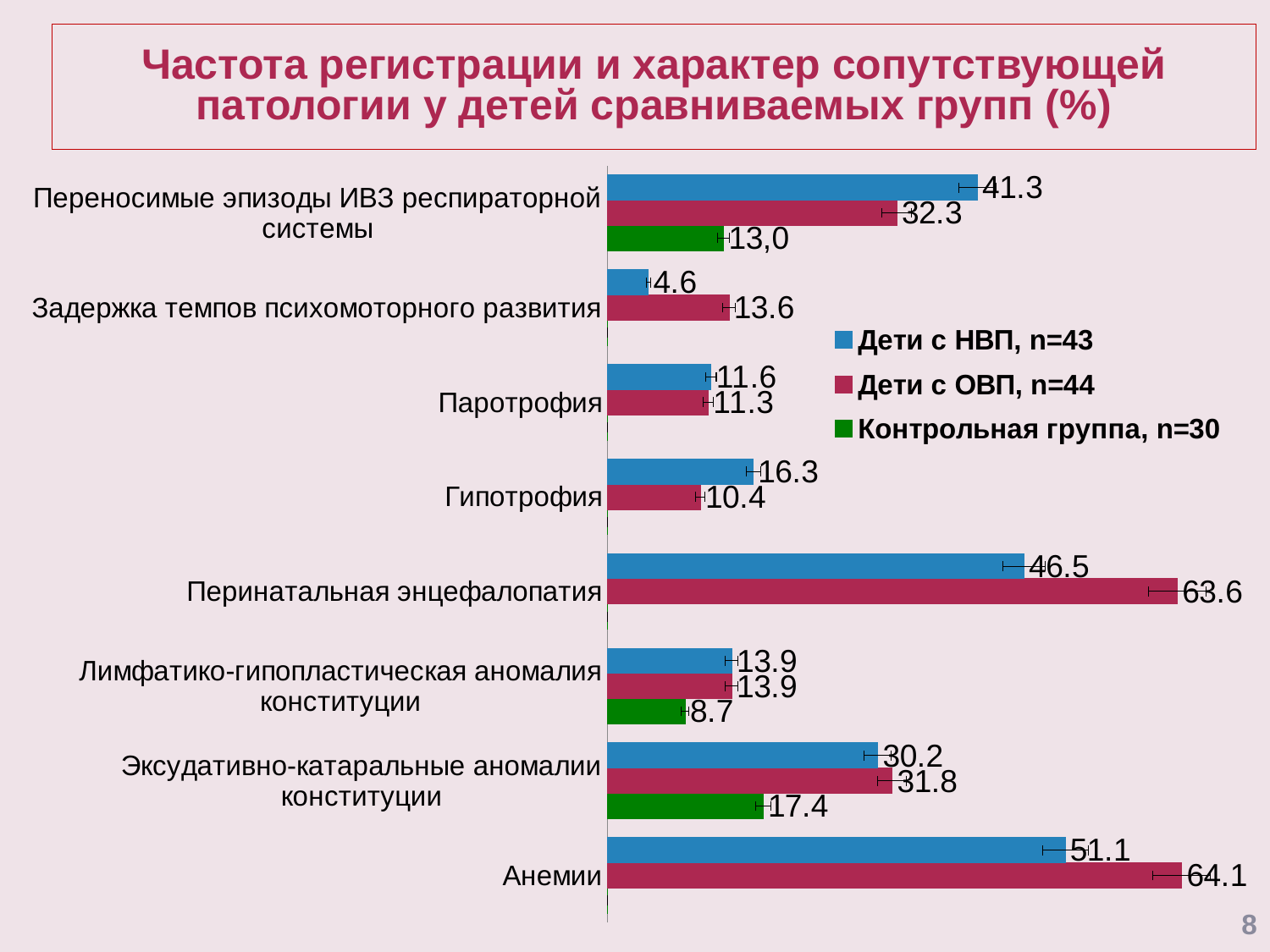
Which colour represents Контрольная группа, n=30 in the legend? Green For Гипотрофия, which series has the larger value: Дети с НВП, n=43 or Дети с ОВП, n=44? Дети с НВП, n=43 How many categories are shown on the chart? 8 What is the value for Контрольная группа, n=30 for Эксудативно-катаральные аномалии конституции? 17.4 Which category has the highest value for Дети с ОВП, n=44? Анемии What is the value for Дети с НВП, n=43 for Анемии? 51.1 What kind of chart is shown on the slide? Bar chart How many series does the legend list? 3 What is the value for Дети с ОВП, n=44 for Перинатальная энцефалопатия? 63.6 Which category has the lowest value for Дети с НВП, n=43? Задержка темпов психомоторного развития What is the difference between the Дети с ОВП, n=44 and Дети с НВП, n=43 values for Перинатальная энцефалопатия? 17.1 What is the value for Дети с НВП, n=43 for Задержка темпов психомоторного развития? 4.6